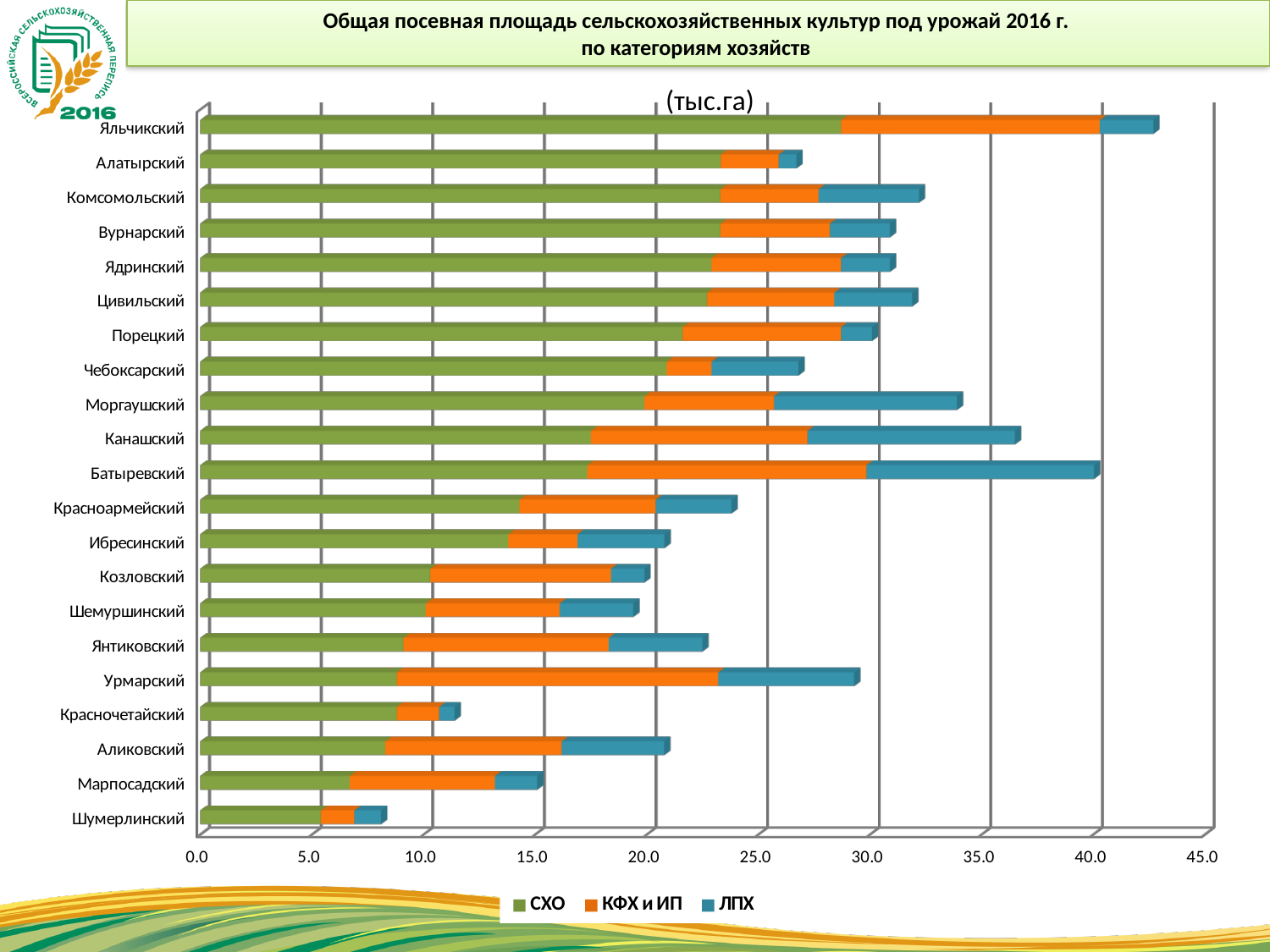
How many districts (categories) are plotted on the chart? 21 Is the total sown area for Шумерлинский greater or less than 10.0? less Which district has the largest total sown area? Яльчикский Which district has the largest СХО segment? Яльчикский Which district has a larger total sown area, Канашский or Моргаушский? Канашский Is the total sown area for Яльчикский greater or less than 40.0? greater Is the total sown area for Канашский greater or less than 35.0? greater Which district has the smallest total sown area? Шумерлинский What unit is shown above the chart? тыс.га What kind of chart is shown on the slide? Stacked bar chart Which district has the largest КФХ и ИП segment? Урмарский How many series does the legend list? 3